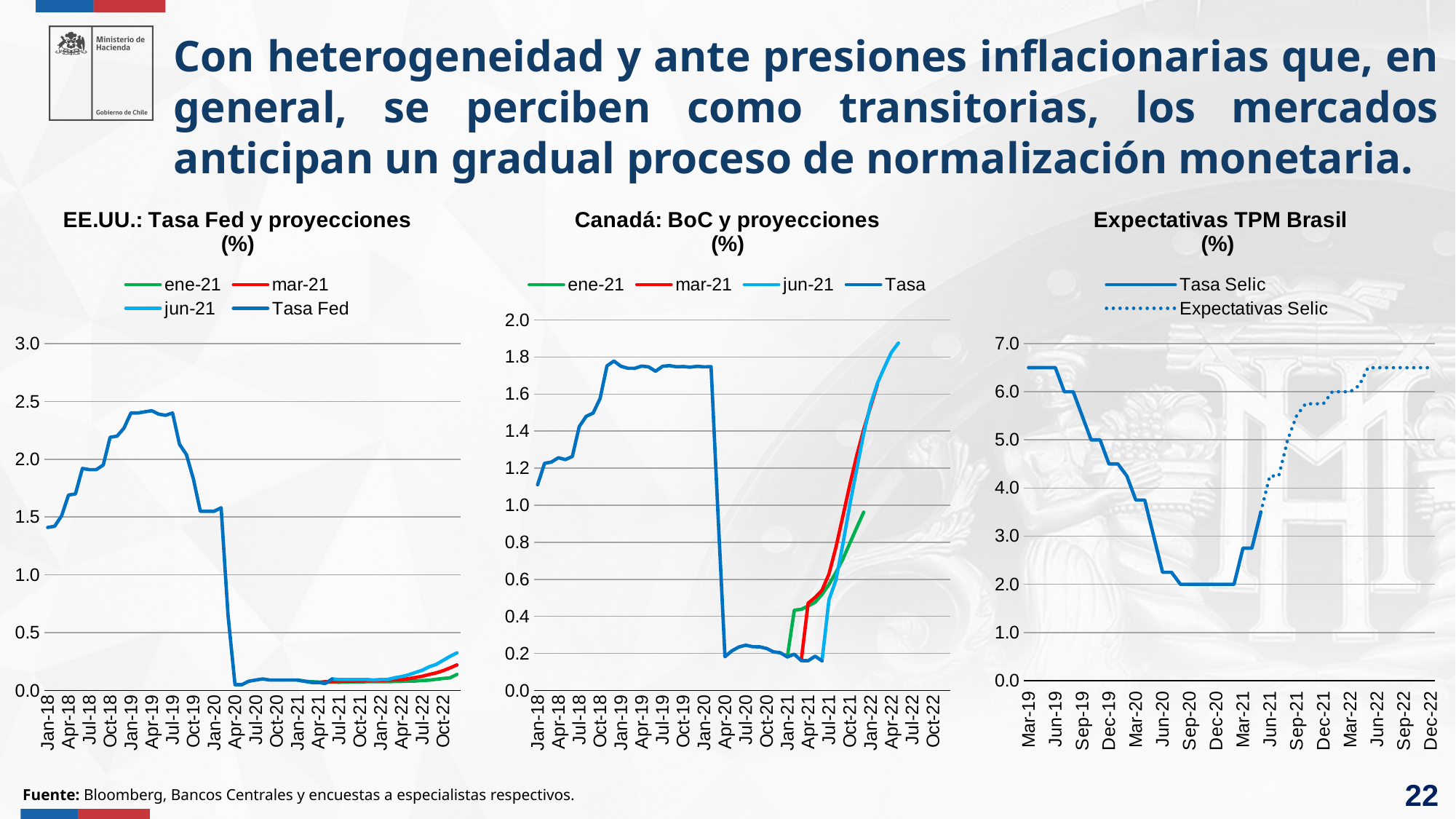
In "Expectativas TPM Brasil (%)", is the Tasa Selic value at Sep-20 greater or less than 3.0? less In "Expectativas TPM Brasil (%)", which series is drawn with a dotted line? Expectativas Selic In "Canadá: BoC y proyecciones (%)", is the Tasa value at Jul-20 greater or less than 0.4? less How many series does the legend of "Canadá: BoC y proyecciones (%)" list? 4 How many series does the legend of "EE.UU.: Tasa Fed y proyecciones (%)" list? 4 How many series does the legend of "Expectativas TPM Brasil (%)" list? 2 What kind of chart is "EE.UU.: Tasa Fed y proyecciones (%)"? line chart In "Expectativas TPM Brasil (%)", do the Expectativas Selic values rise or fall from Jun-21 to Dec-22? rise In "Expectativas TPM Brasil (%)", is the Tasa Selic value at Mar-19 greater or less than 6.0? greater In "Canadá: BoC y proyecciones (%)", at Jan-22 which projection is higher, ene-21 or jun-21? jun-21